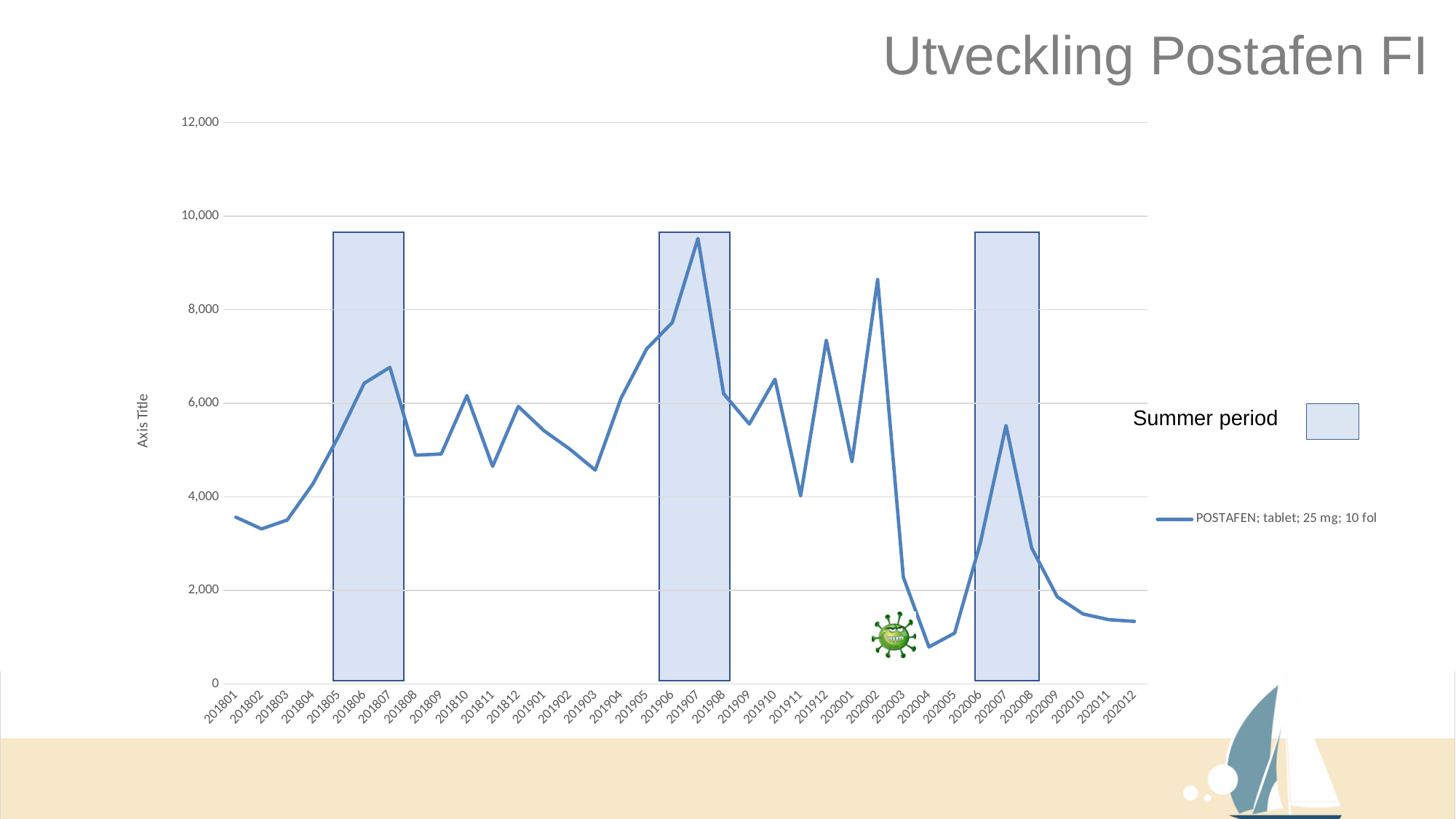
Is the value for 201801 greater or less than 4,000? less How many data series does the line legend list? 1 Which is larger, the value for 201907 or the value for 202002? 201907 How many monthly points are plotted along the x axis? 36 Is the value for 201907 greater or less than 8,000? greater Is the value for 202004 greater or less than 2,000? less Which month has the lowest value on the line? 202004 What is the title of the chart on the slide? Utveckling Postafen FI Do the values rise or fall from 202002 to 202004? fall What kind of chart is shown on the slide? line chart Which month has the highest value on the line? 201907 What do the shaded blue rectangles on the chart represent, according to the legend? Summer period